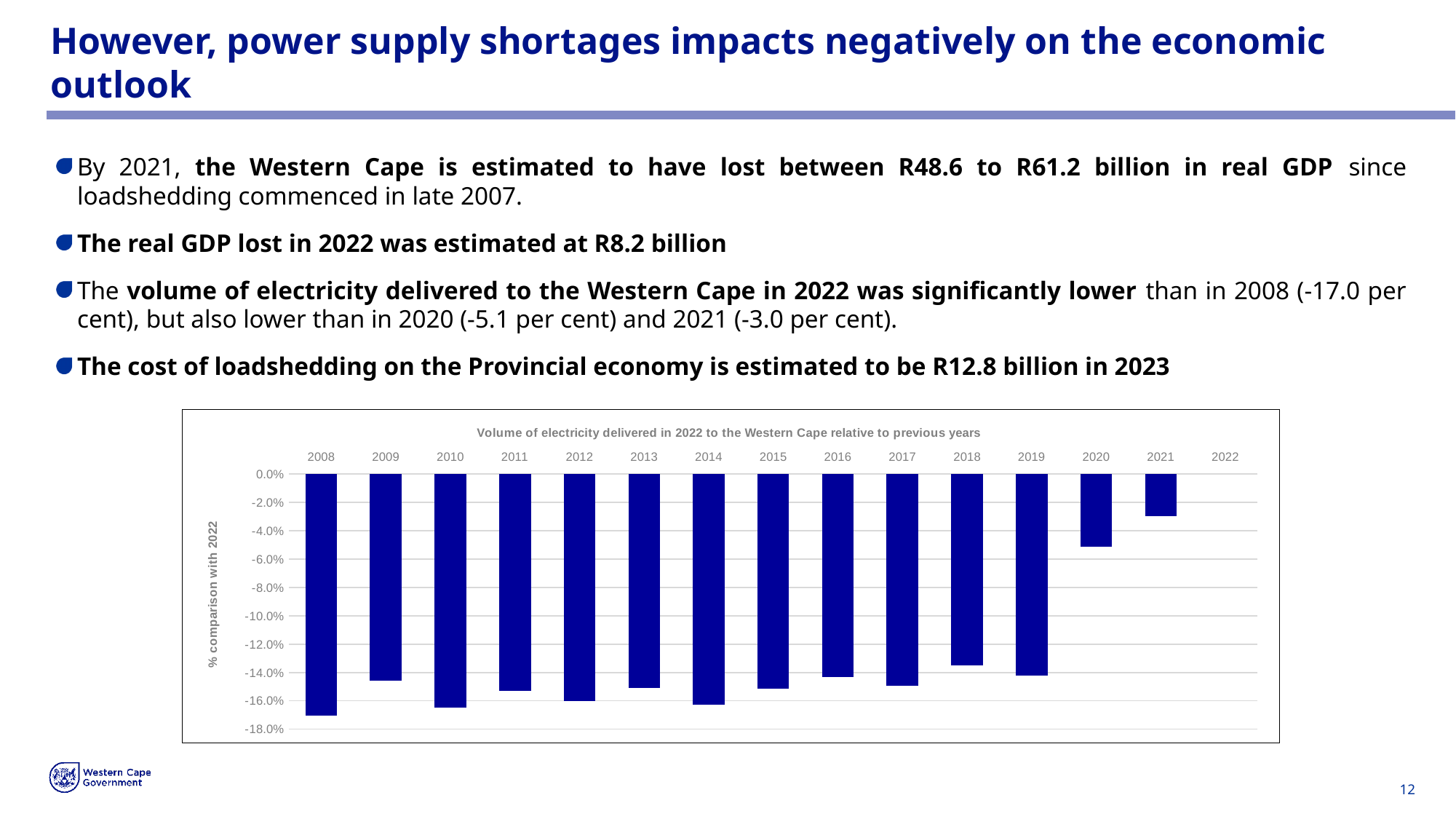
Which year has the larger (less negative) value, 2020 or 2021? 2021 What kind of chart is shown on the slide? Bar chart How many years are labelled along the x axis of the chart? 15 Is the value for 2020 greater or less than -4.0%? less Is the value for 2018 greater or less than -12.0%? less Among the years with a visible bar, which year shows the smallest decline relative to 2022? 2021 What is the title of the chart? Volume of electricity delivered in 2022 to the Western Cape relative to previous years Is the value for 2021 greater or less than -4.0%? greater Which year shows the largest decline relative to 2022? 2008 From 2019 to 2021, do the values rise or fall? rise What is the label on the vertical axis of the chart? % comparison with 2022